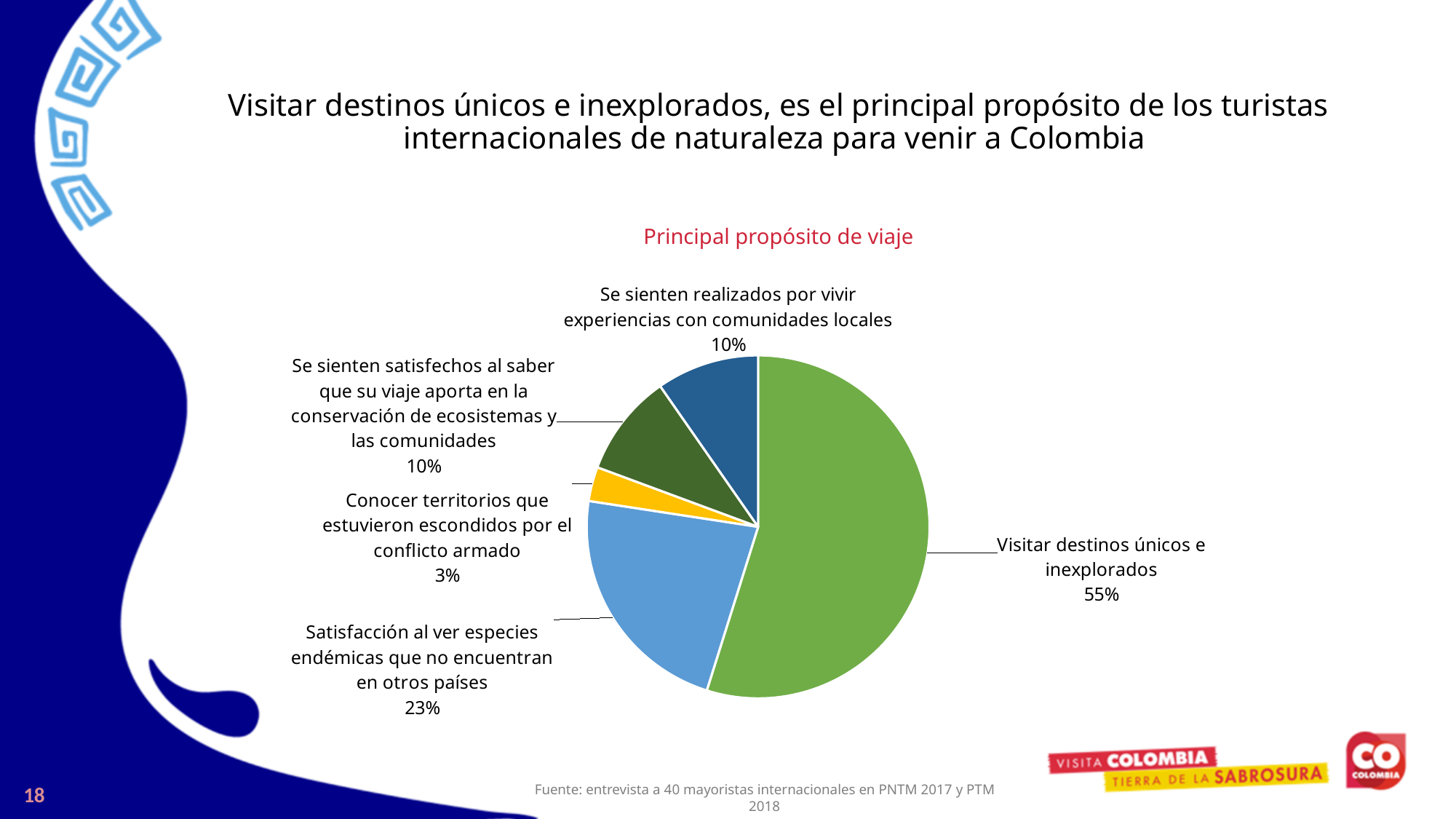
Which is larger: the share for 'Satisfacción al ver especies endémicas que no encuentran en otros países' or the share for 'Se sienten satisfechos al saber que su viaje aporta en la conservación de ecosistemas y las comunidades'? Satisfacción al ver especies endémicas que no encuentran en otros países What percentage is shown for 'Conocer territorios que estuvieron escondidos por el conflicto armado'? 3% Which category has the smallest slice of the pie? Conocer territorios que estuvieron escondidos por el conflicto armado What share is shown for 'Satisfacción al ver especies endémicas que no encuentran en otros países'? 23% What is the title of the chart? Principal propósito de viaje What colour is the slice for 'Conocer territorios que estuvieron escondidos por el conflicto armado'? Yellow What percentage is shown for 'Se sienten realizados por vivir experiencias con comunidades locales'? 10% What is the difference in percentage points between 'Visitar destinos únicos e inexplorados' and 'Satisfacción al ver especies endémicas que no encuentran en otros países'? 32 percentage points Which category has the largest slice of the pie? Visitar destinos únicos e inexplorados What type of chart is shown on the slide? Pie chart How many categories are shown in the pie chart? 5 What percentage of the pie corresponds to 'Visitar destinos únicos e inexplorados'? 55%